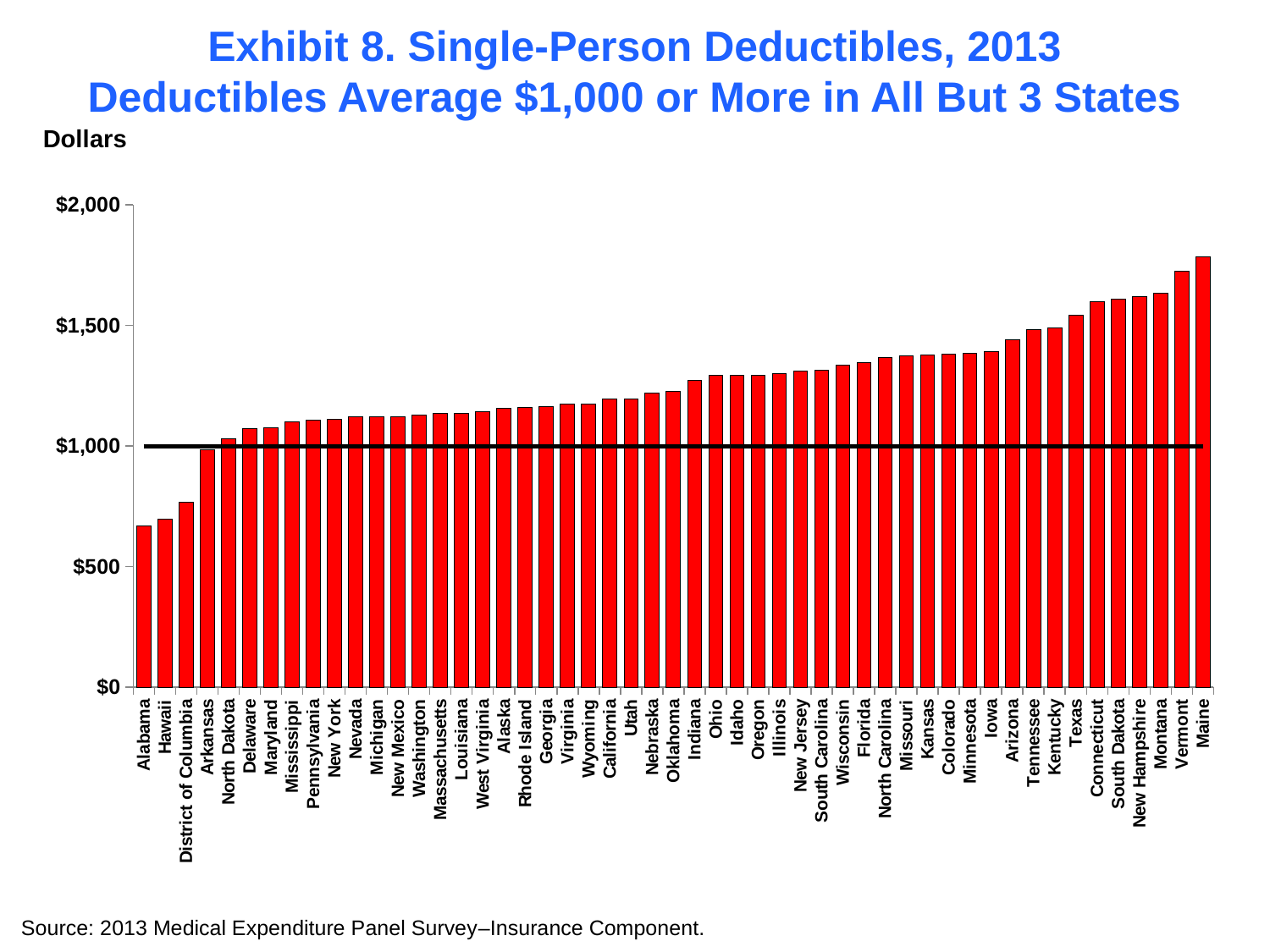
Is the value for Vermont greater or less than $1,500? greater Do the bar values rise or fall moving from left to right along the x axis? Rise How many bars (states plus the District of Columbia) are plotted in the chart? 51 Is the value for Ohio greater or less than $1,000? greater What kind of chart is shown on the slide? Bar chart Which state has the highest single-person deductible in the chart? Maine Is the value for Hawaii greater or less than $1,000? less Which has a larger single-person deductible, Maine or Alabama? Maine Which state has the lowest single-person deductible in the chart? Alabama What value does the horizontal black reference line across the chart mark? $1,000